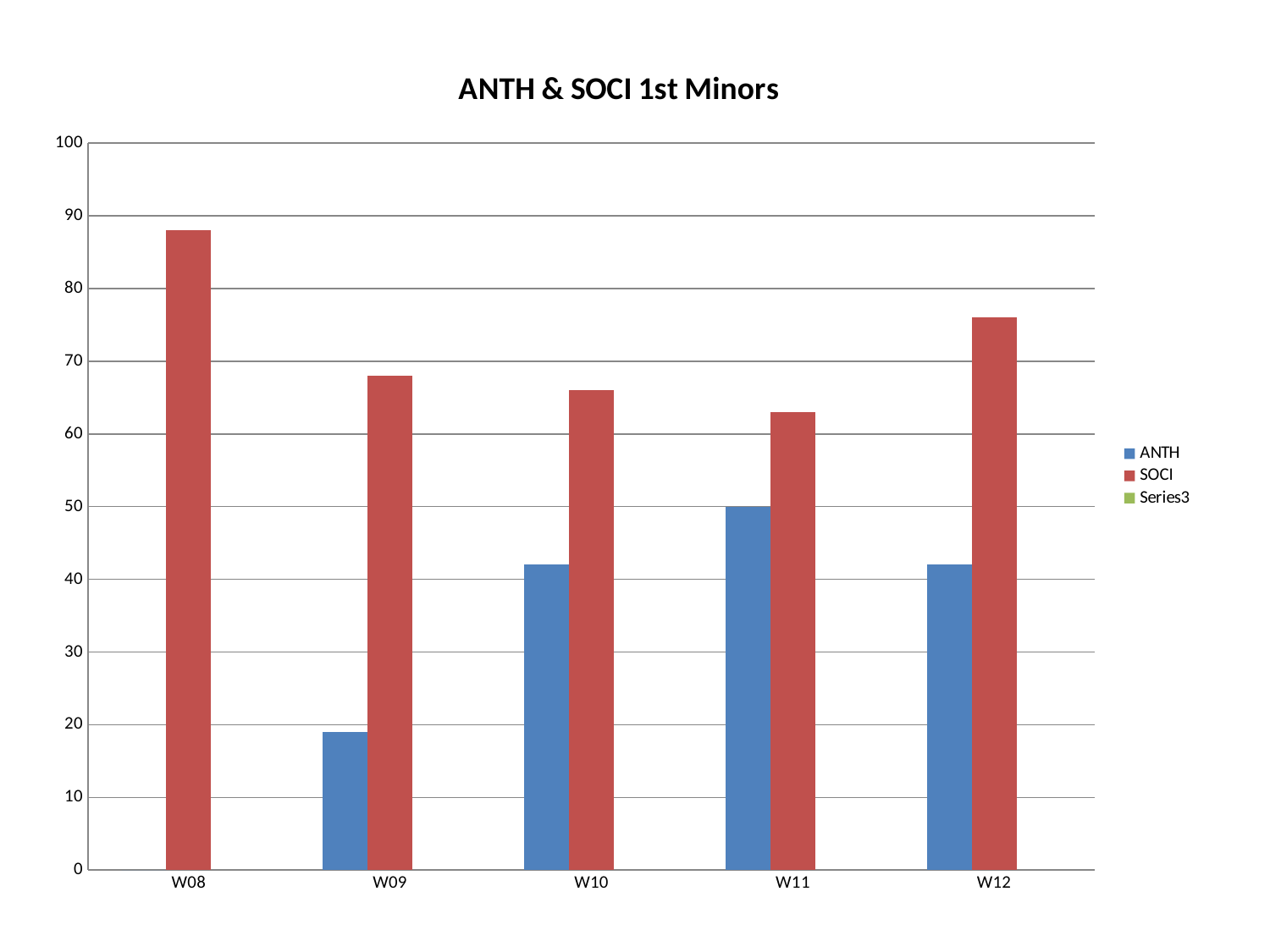
How many categories are shown on the x axis? 5 Is the SOCI value for W12 greater or less than 70? greater How many series does the legend list? 3 Which is larger, the SOCI value for W08 or the SOCI value for W12? W08 Is the SOCI value for W08 greater or less than 80? greater What is the title of the chart? ANTH & SOCI 1st Minors Which category has the highest SOCI value? W08 Which category has the lowest ANTH value among those with an ANTH bar? W09 What type of chart is shown on the slide? bar chart Does the ANTH value rise or fall from W09 to W11? rise Is the ANTH value for W09 greater or less than 20? less Which category has the highest ANTH value? W11